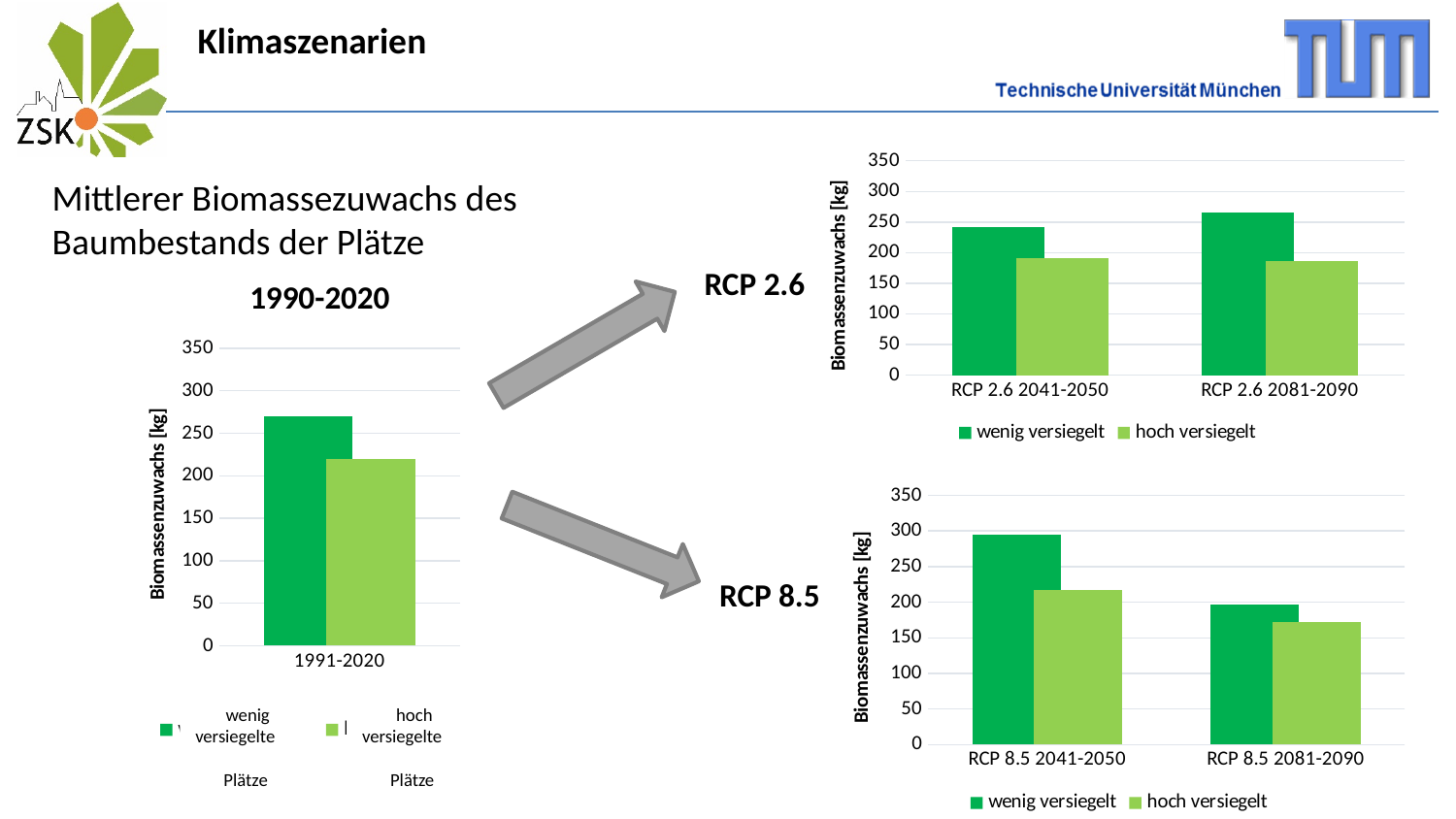
In the RCP 8.5 chart, is the hoch versiegelt value for RCP 8.5 2081-2090 greater or less than 200? less In the RCP 8.5 chart, which bar is the highest? wenig versiegelt, RCP 8.5 2041-2050 In the 1990-2020 chart on the left, is the value for wenig versiegelte Plätze greater or less than 250? greater In the 1990-2020 chart on the left, is the value for hoch versiegelte Plätze greater or less than 200? greater In the RCP 8.5 chart, which is larger: the wenig versiegelt value for RCP 8.5 2041-2050 or for RCP 8.5 2081-2090? RCP 8.5 2041-2050 What kind of chart is the RCP 8.5 chart at the bottom right? bar chart How many series does the legend of the RCP 2.6 chart list? 2 In the RCP 8.5 chart, does the wenig versiegelt series rise or fall from RCP 8.5 2041-2050 to RCP 8.5 2081-2090? fall How many categories are shown on the x axis of the RCP 8.5 chart? 2